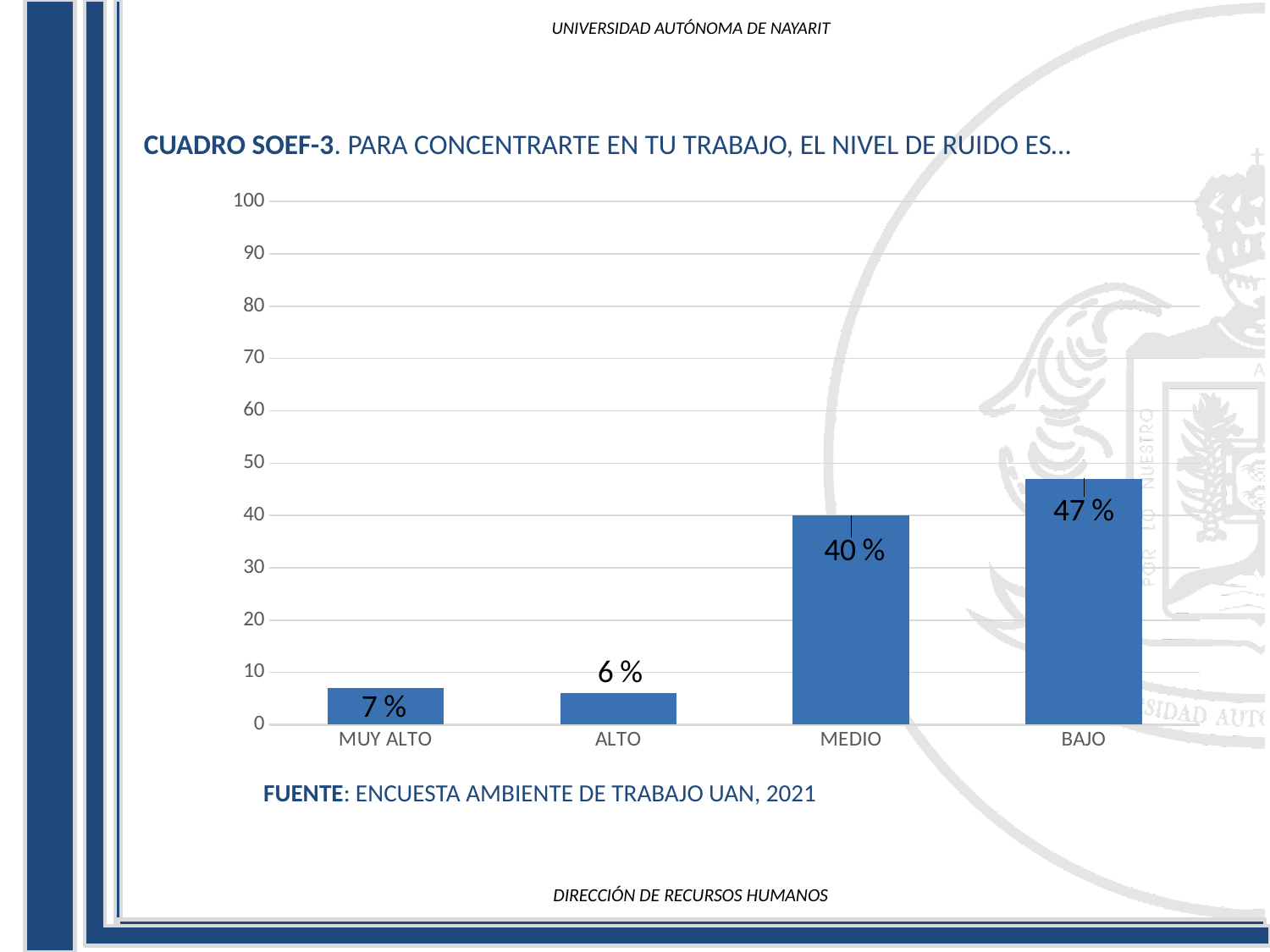
Which is larger, the value for MEDIO or the value for MUY ALTO? MEDIO How many categories are shown on the x axis? 4 What is the value for BAJO? 47 % Is the value for BAJO greater or less than 50? less What is the value for ALTO? 6 % What is the value for MEDIO? 40 % What kind of chart is shown on the slide? bar chart What is the difference between the values for BAJO and MEDIO? 7 % What is the value for MUY ALTO? 7 % Which category has the highest value? BAJO What is the source cited below the chart? ENCUESTA AMBIENTE DE TRABAJO UAN, 2021 Which category has the lowest value? ALTO